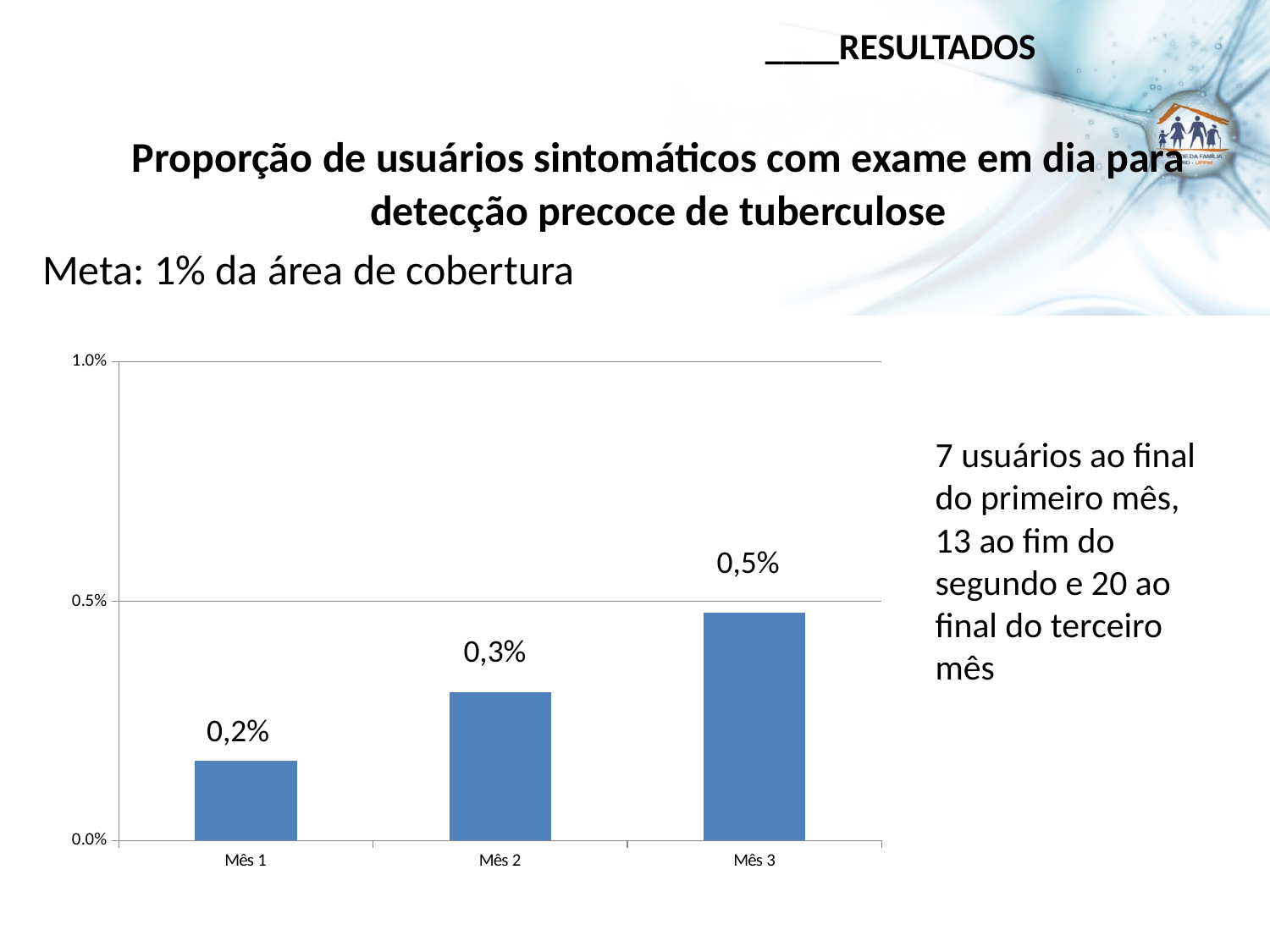
Which month has the lowest value? Mês 1 What is the difference between the values for Mês 3 and Mês 1? 0,3% Which is larger, the value for Mês 2 or the value for Mês 3? Mês 3 What is the highest value shown on the vertical axis? 1.0% What kind of chart is shown on the slide? bar chart What is the value for Mês 3? 0,5% Do the values rise or fall from Mês 1 to Mês 3? rise Which month has the highest value? Mês 3 How many months are shown on the x axis? 3 What is the value for Mês 2? 0,3% What is the value for Mês 1? 0,2% Is the value for Mês 1 greater or less than 0.5%? less